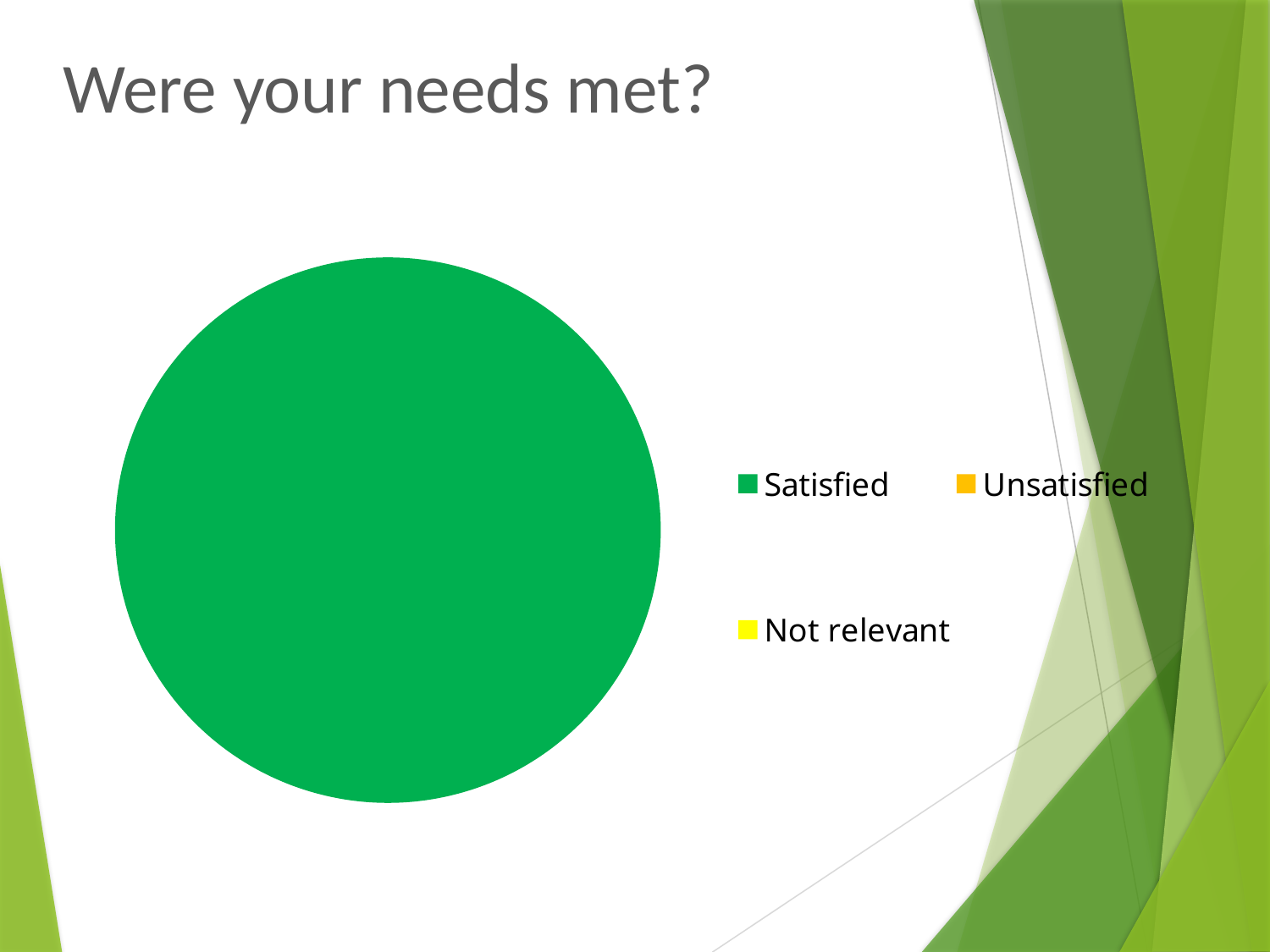
How many entries does the legend list? 3 How many categories are listed in the legend of the pie chart? 3 What kind of chart is shown on the slide? pie chart Which is larger in the pie chart, Satisfied or Unsatisfied? Satisfied Which legend entry is shown in yellow? Not relevant Which category takes up the largest share of the pie? Satisfied What is the title of the slide? Were your needs met? What colour represents Satisfied in the legend? green Which is larger in the pie chart, Satisfied or Not relevant? Satisfied